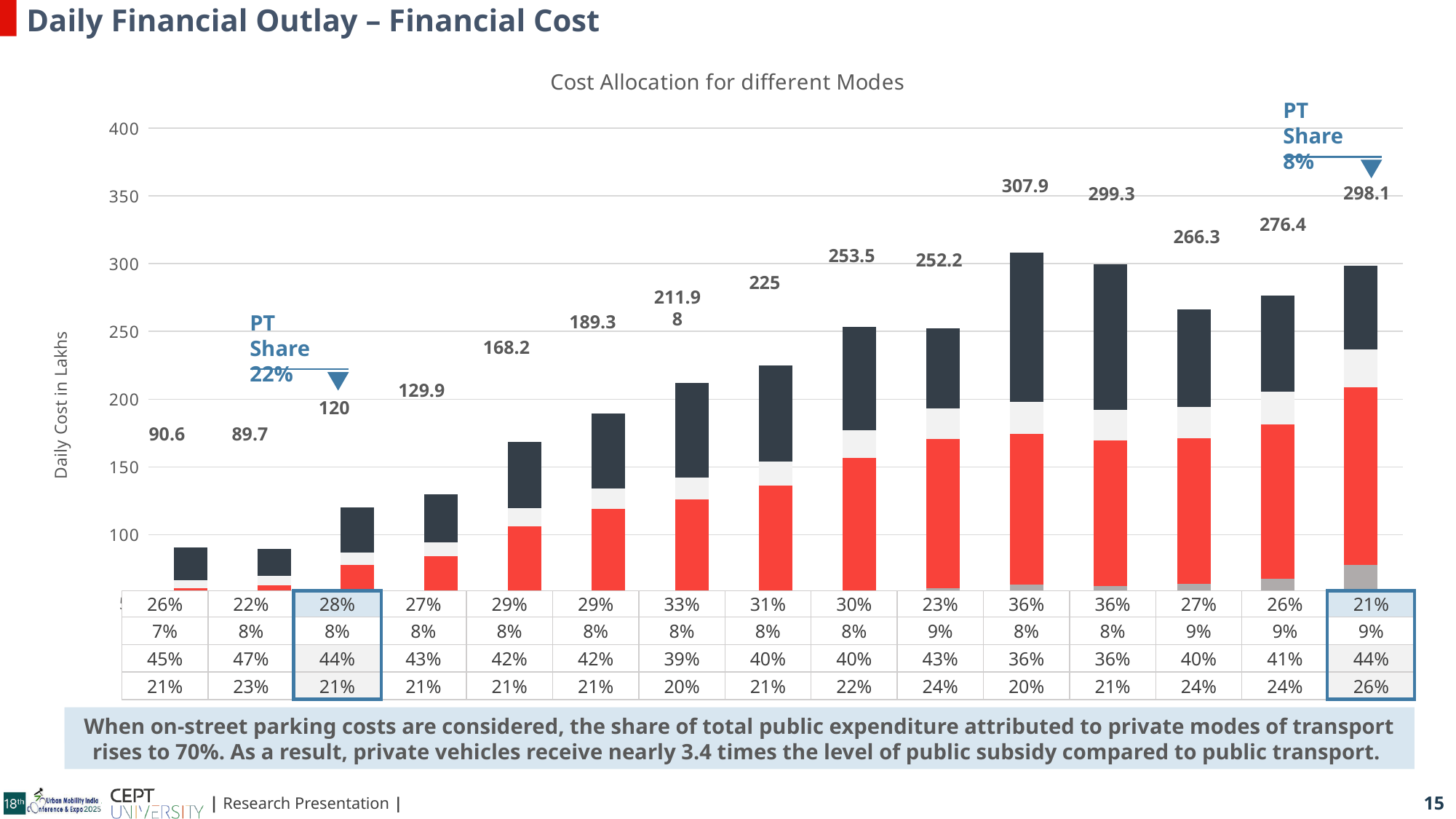
What is the lowest total value labelled on any bar in the chart? 89.7 Is the total of the first bar greater or less than 100? less What is the difference between the highest bar total (307.9) and the last bar total (298.1)? 9.8 What is the highest total value labelled on any bar in the chart? 307.9 What is the label on the vertical axis of the chart? Daily Cost in Lakhs What kind of chart is shown on the slide? Stacked bar chart What is the title of the chart? Cost Allocation for different Modes What is the total value labelled on the first (leftmost) bar? 90.6 Which is larger: the bar labelled 299.3 or the bar labelled 276.4? 299.3 How many bars are plotted in the chart? 15 What is the total value labelled on the last (rightmost) bar? 298.1 Do the bar totals generally rise or fall from left to right across the chart? Rise